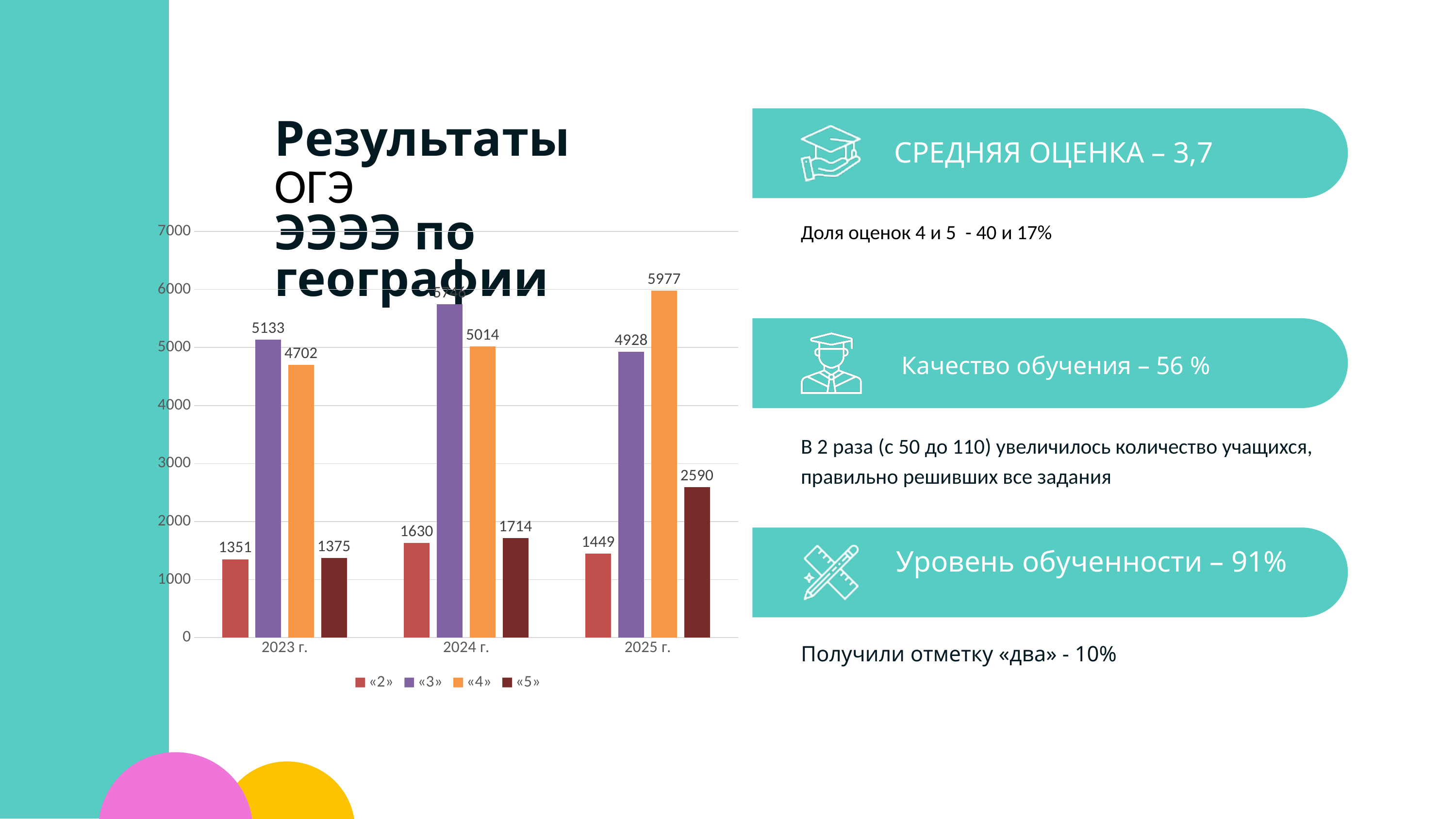
In which year is the value for «2» the lowest? 2023 г. What is the value for «4» in 2025? 5977 In which year is the value for «5» the highest? 2025 г. Is the value for «3» in 2024 greater or less than 5000? greater What is the difference between the «4» values in 2025 and 2024? 963 What is the value for «5» in 2024? 1714 How many series does the chart legend list? 4 What is the value for «2» in 2023? 1351 What is the value for «3» in 2025? 4928 Which is larger in 2023: the value for «3» or the value for «4»? «3» What type of chart is shown on the slide? bar chart How many year categories are shown on the x axis of the chart? 3